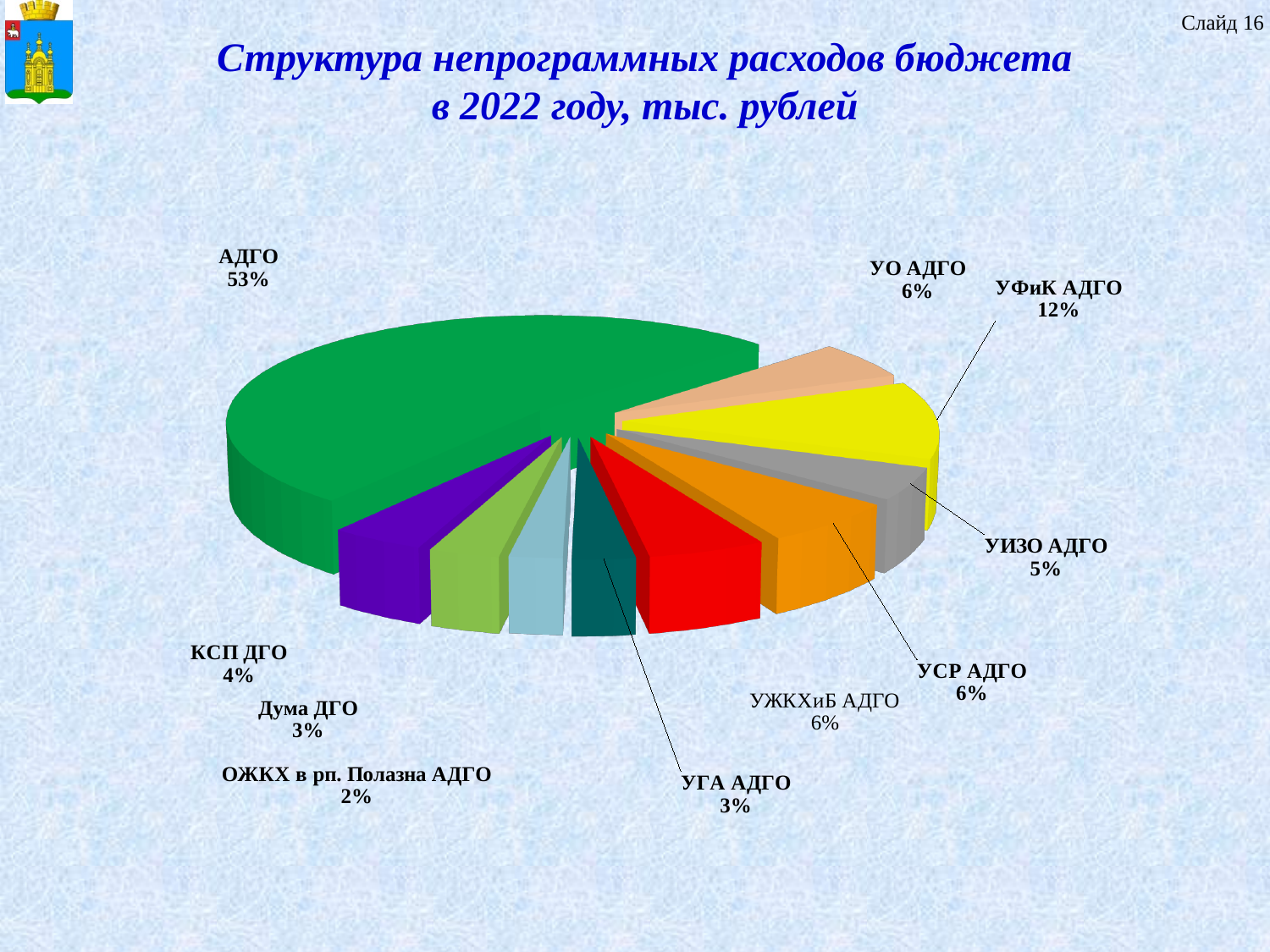
What is the difference in percentage points between АДГО and УФиК АДГО? 41 Which category has the largest share of the pie? АДГО How many categories are shown in the pie chart? 10 What percentage is shown for ОЖКХ в рп. Полазна АДГО? 2% What percentage is shown for УИЗО АДГО? 5% What share of the pie does АДГО account for? 53% What kind of chart is shown on the slide? Pie chart Which is larger, the share for КСП ДГО or the share for Дума ДГО? КСП ДГО What percentage is shown for УФиК АДГО? 12% Which category has the smallest share of the pie? ОЖКХ в рп. Полазна АДГО What percentage is shown for УСР АДГО? 6% What is the title of the chart? Структура непрограммных расходов бюджета в 2022 году, тыс. рублей